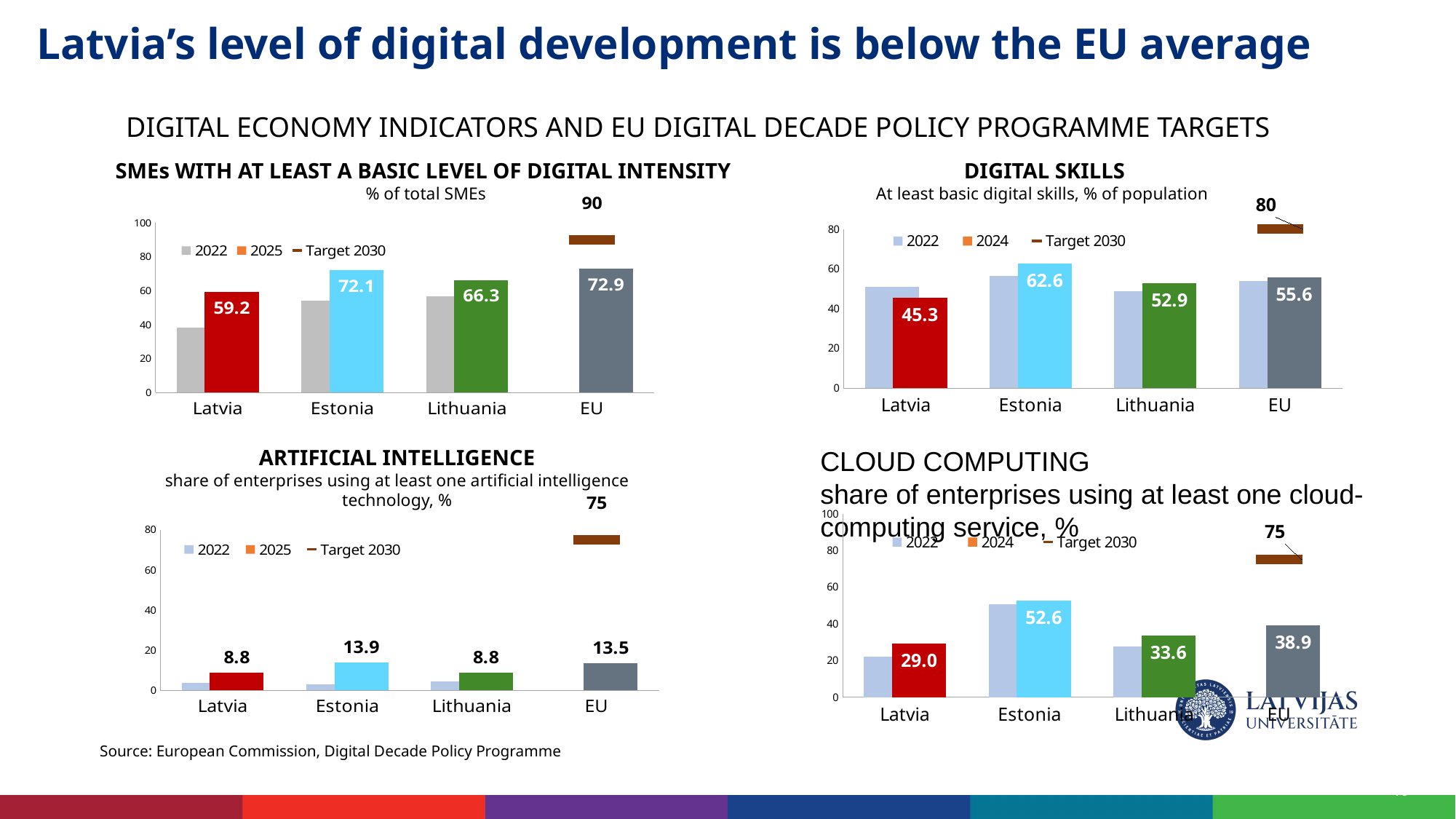
In the 'Digital skills' chart, what is the difference between the 2024 values for EU and Latvia? 10.3 In the 'Cloud computing' chart, what is the 2024 value for Lithuania? 33.6 In the 'Digital skills' chart, which country or region has the highest 2024 value? Estonia In the 'SMEs with at least a basic level of digital intensity' chart, what is the Target 2030 value? 90 What kind of chart is the 'SMEs with at least a basic level of digital intensity' chart? Bar chart In the 'Artificial intelligence' chart, which is larger: the 2025 value for Estonia or for EU? Estonia In the 'Artificial intelligence' chart, what is the 2025 value for Estonia? 13.9 How many series does the legend of the 'Artificial intelligence' chart list? 3 In the 'Cloud computing' chart, is the 2022 value for Estonia greater or less than 40? greater In the 'SMEs with at least a basic level of digital intensity' chart, what is the 2025 value for Latvia? 59.2 In the 'Cloud computing' chart, which country or region has the lowest 2024 value? Latvia How many categories are shown on the x axis of the 'Digital skills' chart? 4